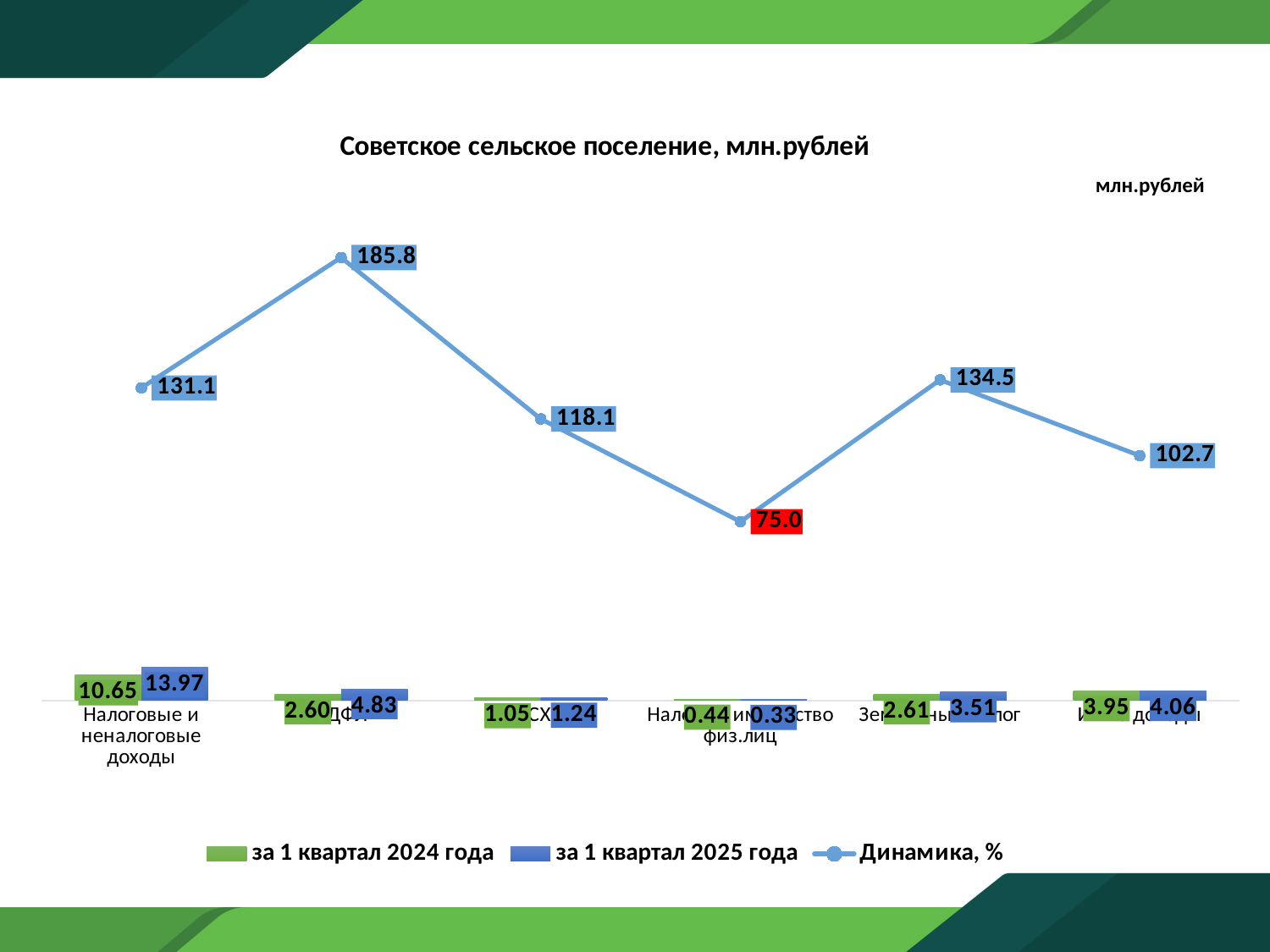
How many series does the legend list? 3 What is the difference between the 2025 and 2024 values for 'Налоговые и неналоговые доходы'? 3.32 What is the title of the chart? Советское сельское поселение, млн.рублей What is the value for 'Налоговые и неналоговые доходы' in the series 'за 1 квартал 2025 года'? 13.97 What is the 'Динамика, %' value for 'Налог на имущество физ.лиц'? 75.0 For 'Налог на имущество физ.лиц', which is larger: the value for 'за 1 квартал 2024 года' or 'за 1 квартал 2025 года'? за 1 квартал 2024 года What is the 'Динамика, %' value for 'Налоговые и неналоговые доходы'? 131.1 What is the value for 'Налоговые и неналоговые доходы' in the series 'за 1 квартал 2024 года'? 10.65 Which category has the lowest 'Динамика, %' value? Налог на имущество физ.лиц How many categories are shown on the x axis? 6 What kind of chart is this? Combination bar and line chart What is the highest value on the 'Динамика, %' line? 185.8